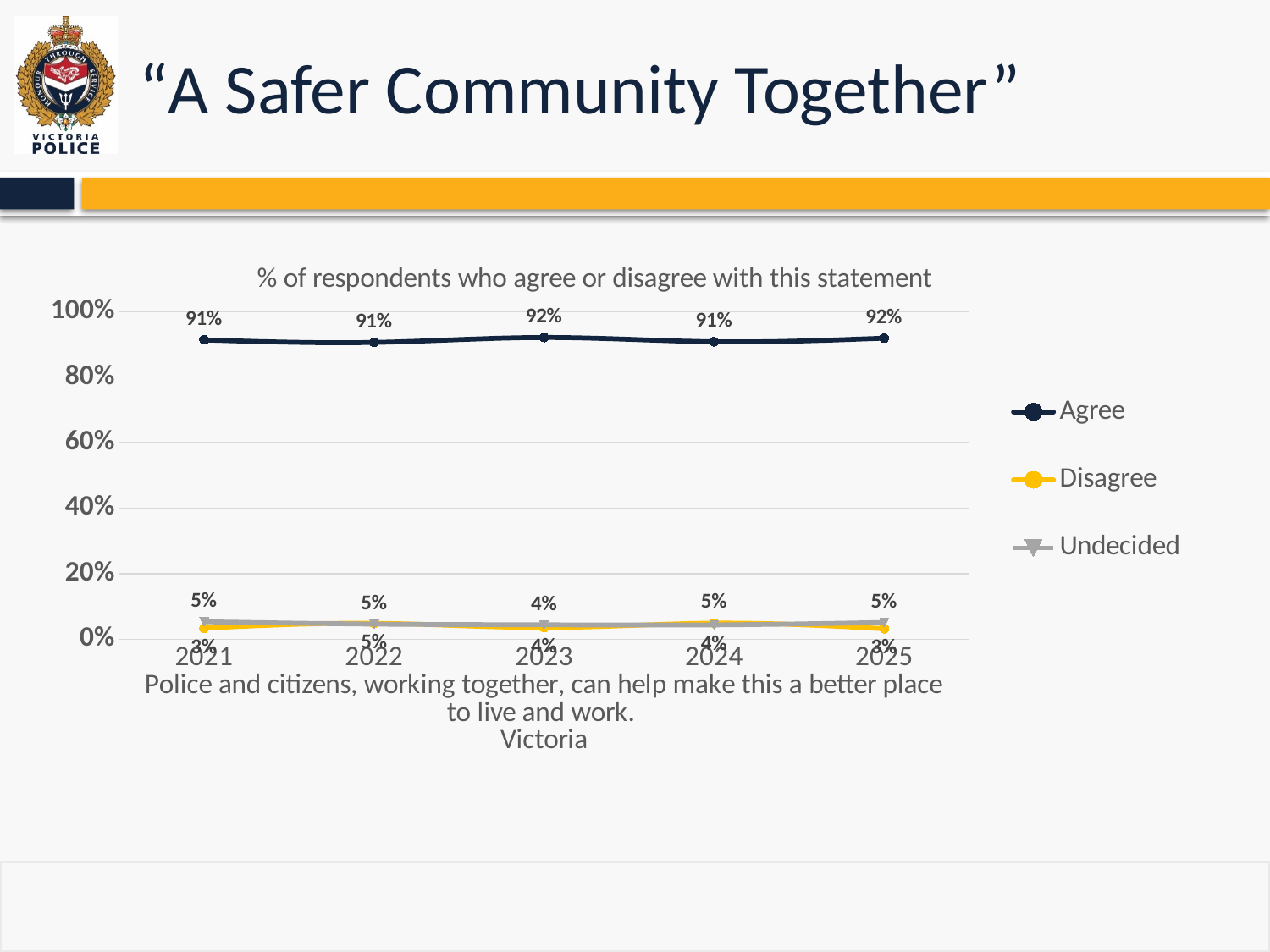
What kind of chart is shown on the slide? line chart In 2025, which is larger: the Agree value or the Undecided value? Agree What is the Agree value for 2021? 91% What is the Undecided value for 2023? 4% What is the Undecided value for 2024? 4% How many series does the legend list? 3 What percentage of respondents agreed with the statement in 2023? 92% What are the three entries listed in the chart legend? Agree, Disagree, Undecided Is the Agree value for 2024 greater or less than 80%? greater How many years are plotted along the x axis? 5 By how many percentage points did the Agree value change from 2021 to 2023? 1 percentage point Does the Agree line rise sharply, fall sharply, or stay roughly flat from 2021 to 2025? roughly flat